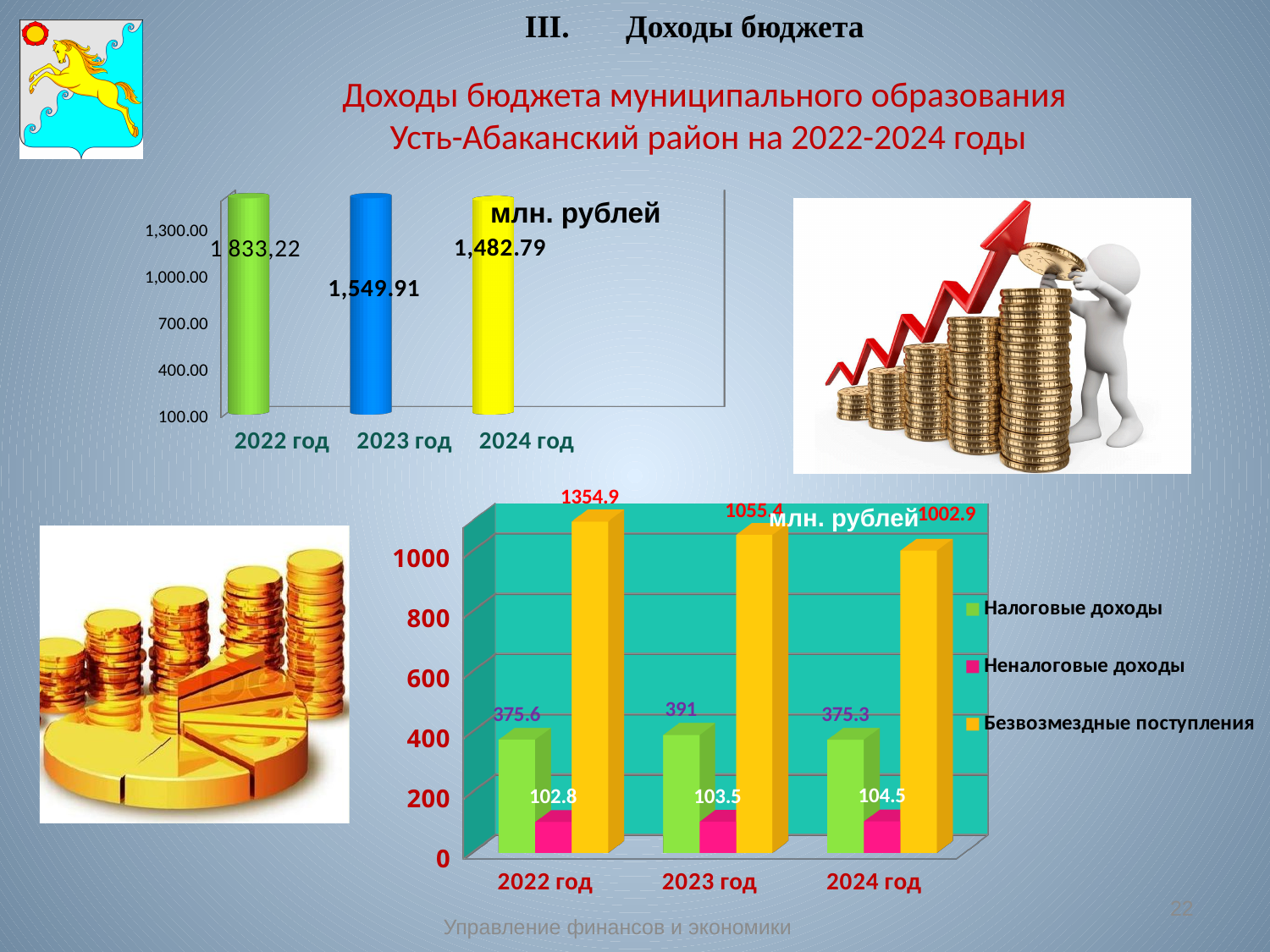
In the bottom chart, how many series does the legend list? 3 In the top chart, what is the value for 2024 год? 1,482.79 In the bottom chart, which series is shown in yellow? Безвозмездные поступления In the top chart, what is the difference between the values for 2023 год and 2024 год? 67.12 In the bottom chart, what is the value of Безвозмездные поступления for 2022 год? 1354.9 In the bottom chart, which year has the highest value of Безвозмездные поступления? 2022 год In the bottom chart, what is the value of Неналоговые доходы for 2024 год? 104.5 In the bottom chart, do the values of Безвозмездные поступления rise or fall from 2022 год to 2024 год? fall In the top chart, which year has the lowest value? 2024 год In the top chart, what is the value for 2023 год? 1,549.91 In the bottom chart, what is the value of Налоговые доходы for 2023 год? 391 In the top chart, how many years are shown on the x axis? 3